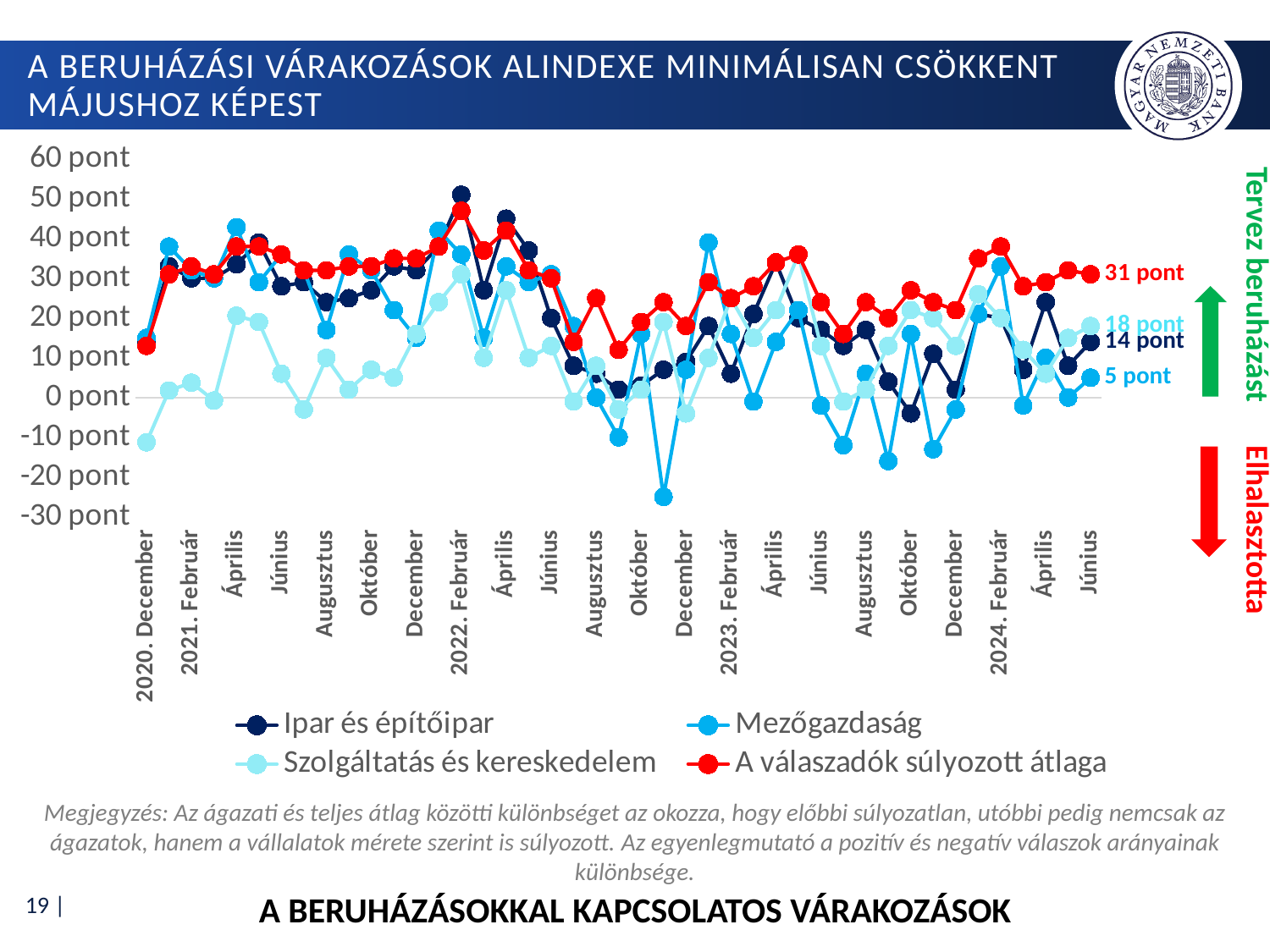
What kind of chart is shown on the slide? line chart What is the difference between the end-of-line values of 'A válaszadók súlyozott átlaga' and 'Mezőgazdaság'? 26 pont Which series has the highest value at the last data point (2024 Június)? A válaszadók súlyozott átlaga What is the value labelled at the end of the line for 'A válaszadók súlyozott átlaga'? 31 pont What is the value labelled at the end of the line for 'Mezőgazdaság'? 5 pont Is the value for 'Ipar és építőipar' in 2022 Február greater or less than 40 pont? greater Is the value for 'Mezőgazdaság' in 2022 December greater or less than -20 pont? greater What is the value labelled at the end of the line for 'Szolgáltatás és kereskedelem'? 18 pont How many series does the legend list? 4 Which series has the lowest value at the last data point (2024 Június)? Mezőgazdaság What is the value labelled at the end of the line for 'Ipar és építőipar'? 14 pont At the last data point, which is higher: 'Szolgáltatás és kereskedelem' or 'Ipar és építőipar'? Szolgáltatás és kereskedelem